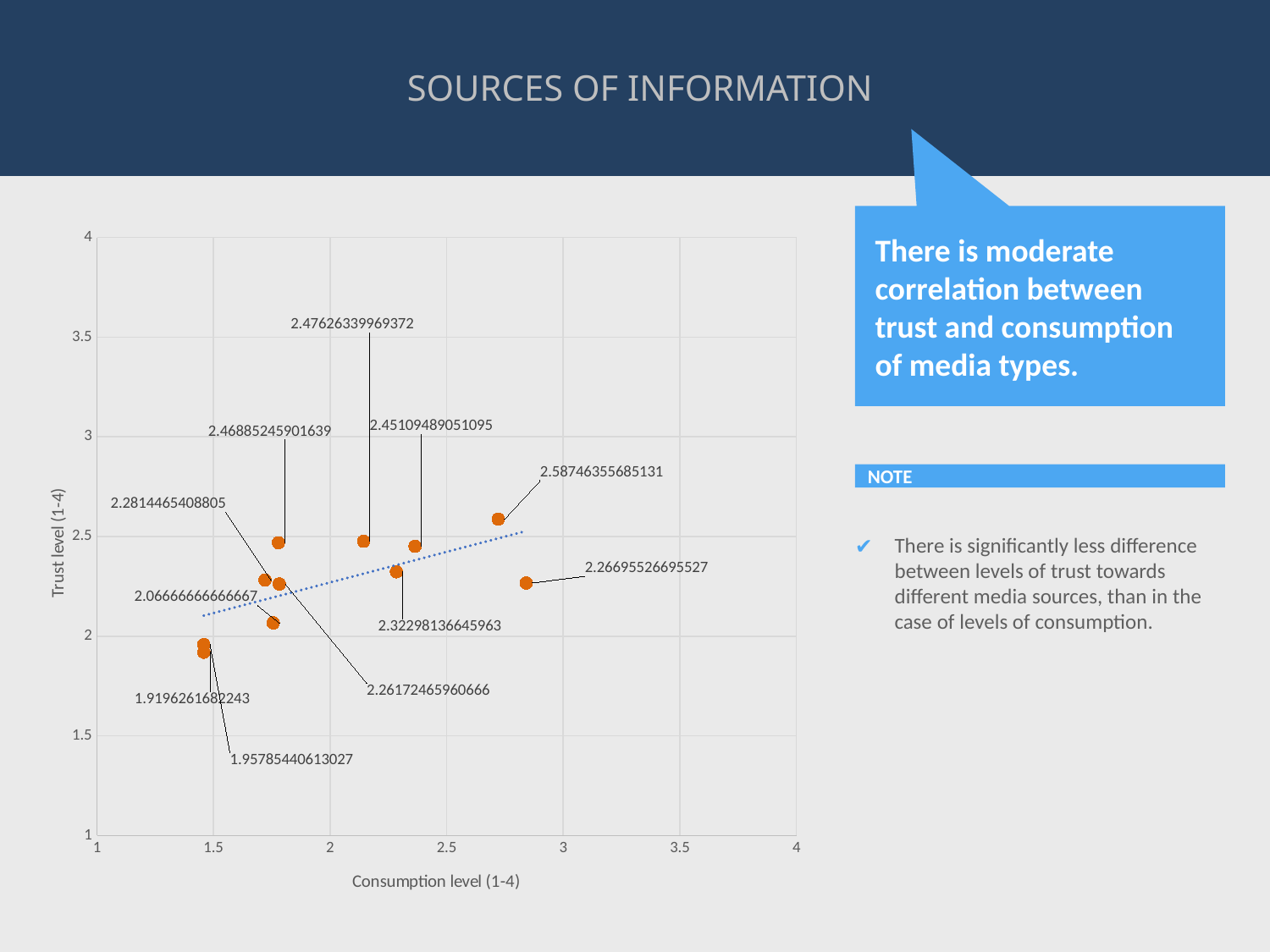
How many points have a consumption level greater than 2.5? 2 What is the title of the horizontal axis? Consumption level (1-4) What is the difference between the highest and lowest labelled trust level values? 0.66783738862701 Does the trend line in the chart rise or fall as consumption level increases? rises What is the highest trust level value labelled in the chart? 2.58746355685131 What is the lowest trust level value labelled in the chart? 1.9196261682243 Is the trust level of the point with the highest consumption level greater or less than 2.5? less What is the title of the vertical axis? Trust level (1-4) Is the trust level of the points with the lowest consumption level greater or less than 2? less Does the point with the highest consumption level also have the highest trust level? No What kind of chart is shown on the slide? scatter chart How many data points are plotted in the chart? 11